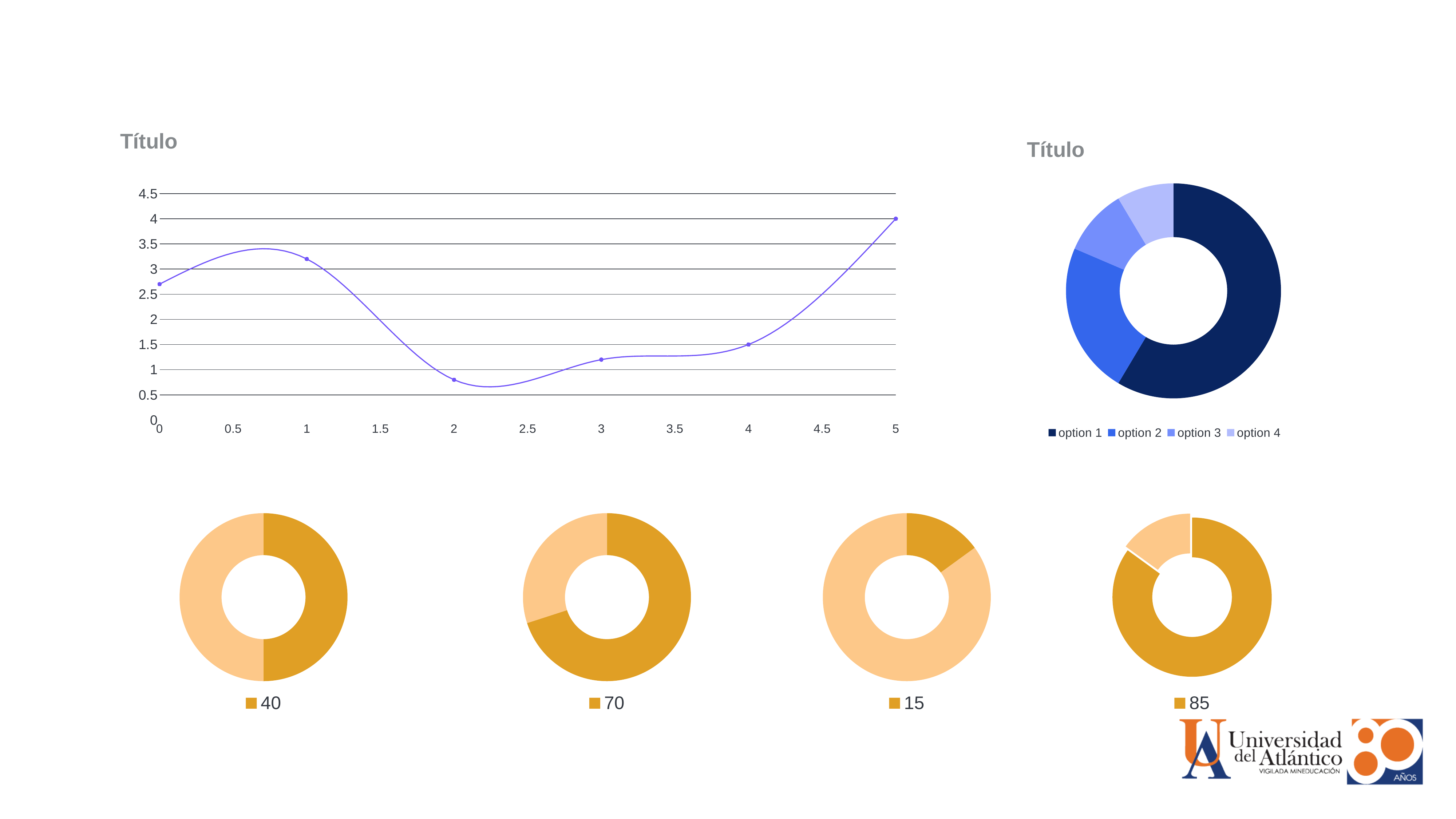
How many small doughnut charts are in the bottom row of the slide, and what is the legend label of the leftmost one? 4; 40 In the top-left line chart, how many data points are plotted? 6 In the top-left line chart, is the value at x = 2 greater or less than 1? less In the top-left line chart, what is the value at x = 4? 1.5 In the top-right doughnut chart, which option has the largest share? option 1 In the top-left line chart, is the value at x = 1 greater or less than 3? greater In the top-left line chart, at which x value is the plotted value lowest? 2 In the top-left line chart, what is the value at x = 5? 4 In the top-left line chart, at which x value is the plotted value highest? 5 In the top-left line chart, which is larger: the value at x = 0 or the value at x = 3? x = 0 What kind of chart is the top-left chart titled "Título"? line chart How many series does the legend of the top-right doughnut chart list? 4